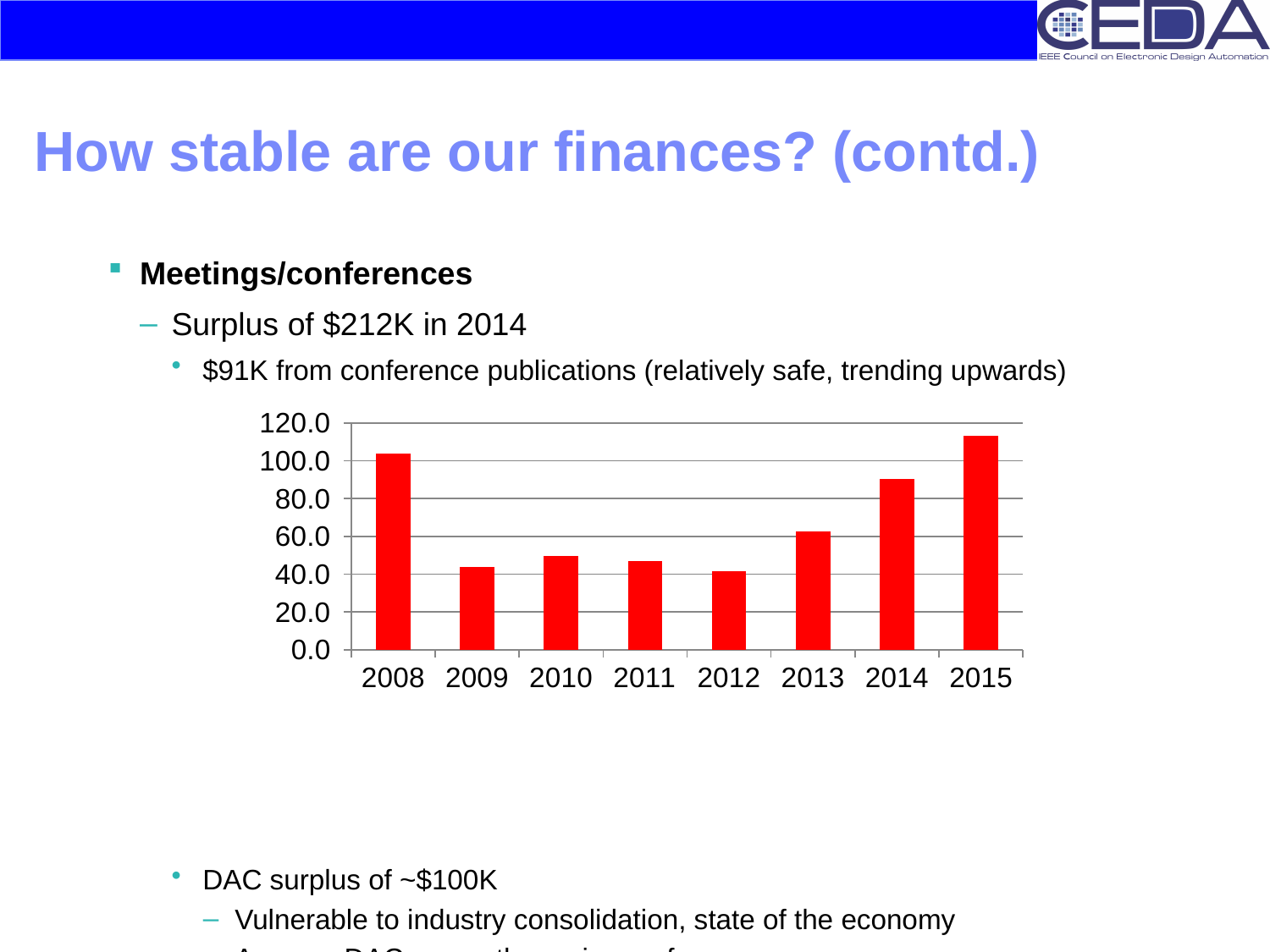
Which year has the highest bar in the chart? 2015 Is the value for 2008 greater or less than 100? greater What kind of chart is shown on the slide? bar chart Which is larger, the value for 2013 or the value for 2010? 2013 Which is larger, the value for 2008 or the value for 2014? 2008 What colour are the bars in the chart? red Is the value for 2014 greater or less than 80? greater How many years are plotted on the x axis of the chart? 8 Is the value for 2015 greater or less than 100? greater Do the values rise or fall from 2012 to 2015? rise